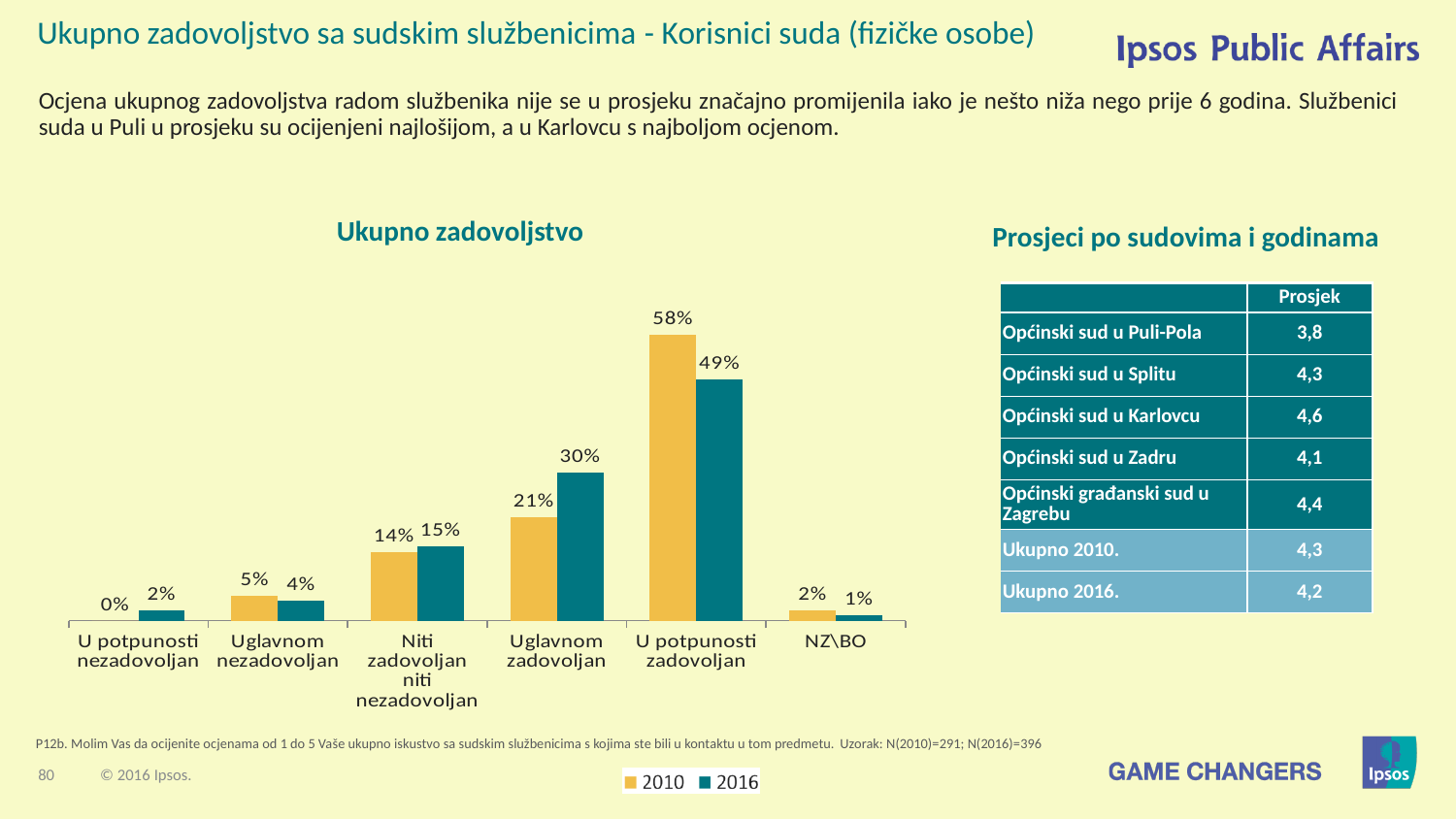
What is the difference between the 2016 and 2010 values for "Uglavnom zadovoljan" in the Ukupno zadovoljstvo chart? 9% How many series does the legend of the Ukupno zadovoljstvo chart list? 2 What is the 2016 value for "U potpunosti nezadovoljan" in the Ukupno zadovoljstvo chart? 2% What is the 2016 value for "Uglavnom zadovoljan" in the Ukupno zadovoljstvo chart? 30% What is the 2010 value for "Niti zadovoljan niti nezadovoljan" in the Ukupno zadovoljstvo chart? 14% How many categories are shown on the x axis of the Ukupno zadovoljstvo chart? 6 Which category has the highest 2016 value in the Ukupno zadovoljstvo chart? U potpunosti zadovoljan What is the difference between the 2010 and 2016 values for "U potpunosti zadovoljan" in the Ukupno zadovoljstvo chart? 9% Which category has the lowest 2010 value in the Ukupno zadovoljstvo chart? U potpunosti nezadovoljan In the Ukupno zadovoljstvo chart, is the 2010 or the 2016 value larger for "Uglavnom nezadovoljan"? 2010 What type of chart is the Ukupno zadovoljstvo chart? Bar chart What is the 2010 value for "U potpunosti zadovoljan" in the Ukupno zadovoljstvo chart? 58%